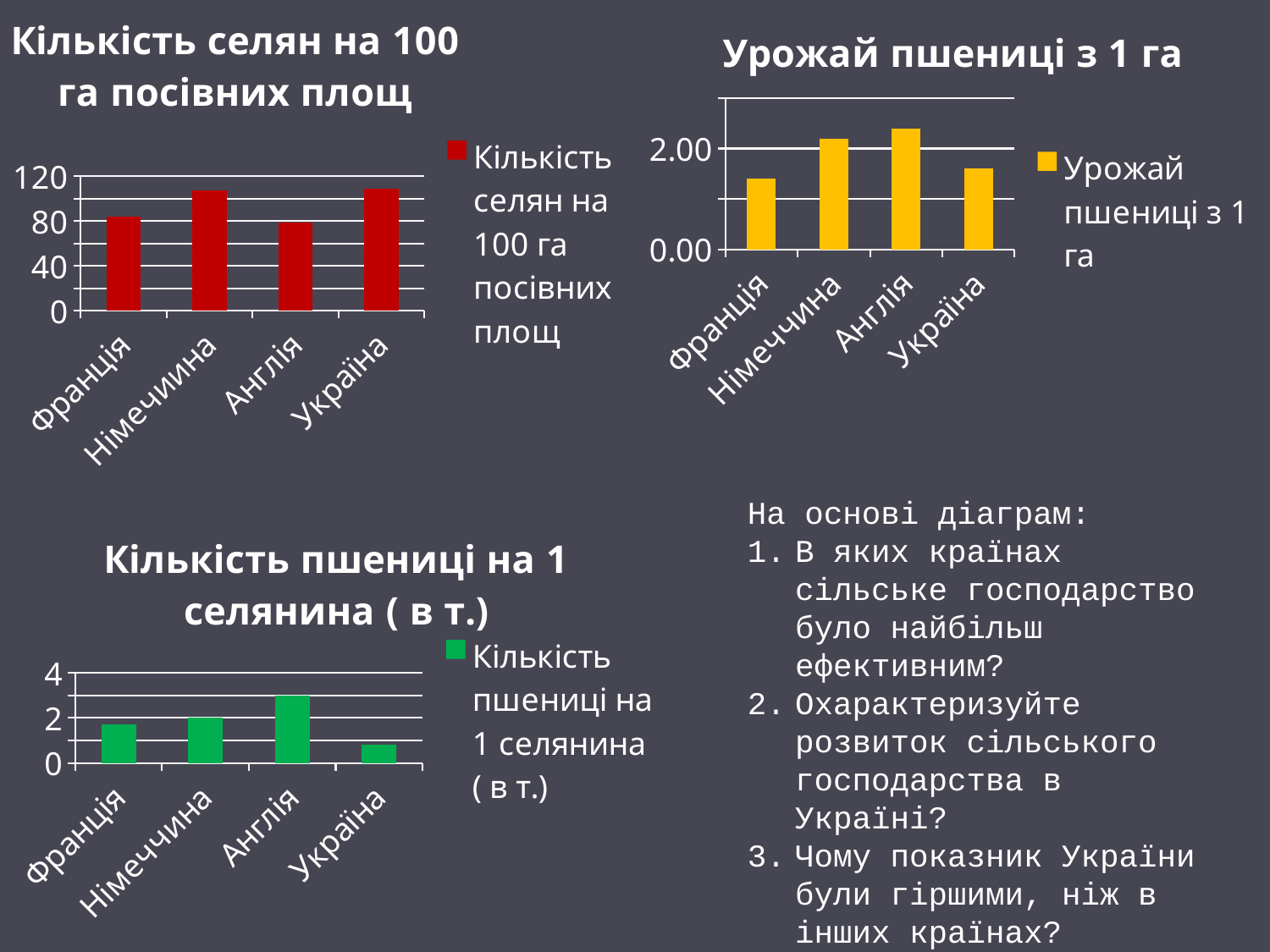
What kind of chart is the chart titled "Кількість пшениці на 1 селянина ( в т.)"? bar chart How many series does the legend of the chart titled "Урожай пшениці з 1 га" list? 1 In the chart titled "Урожай пшениці з 1 га", is the value for Англія greater or less than 2.00? greater In the chart titled "Кількість селян на 100 га посівних площ", is the value for Німеччина greater or less than 80? greater In the chart titled "Урожай пшениці з 1 га", is the value for Франція greater or less than 2.00? less In the chart titled "Урожай пшениці з 1 га", which is larger, the value for Німеччина or the value for Франція? Німеччина In the chart titled "Кількість пшениці на 1 селянина ( в т.)", which country has the highest value? Англія How many countries are shown in the chart titled "Кількість селян на 100 га посівних площ"? 4 In the chart titled "Кількість пшениці на 1 селянина ( в т.)", which country has the lowest value? Україна In the chart titled "Кількість пшениці на 1 селянина ( в т.)", which is larger, the value for Англія or the value for Україна? Англія